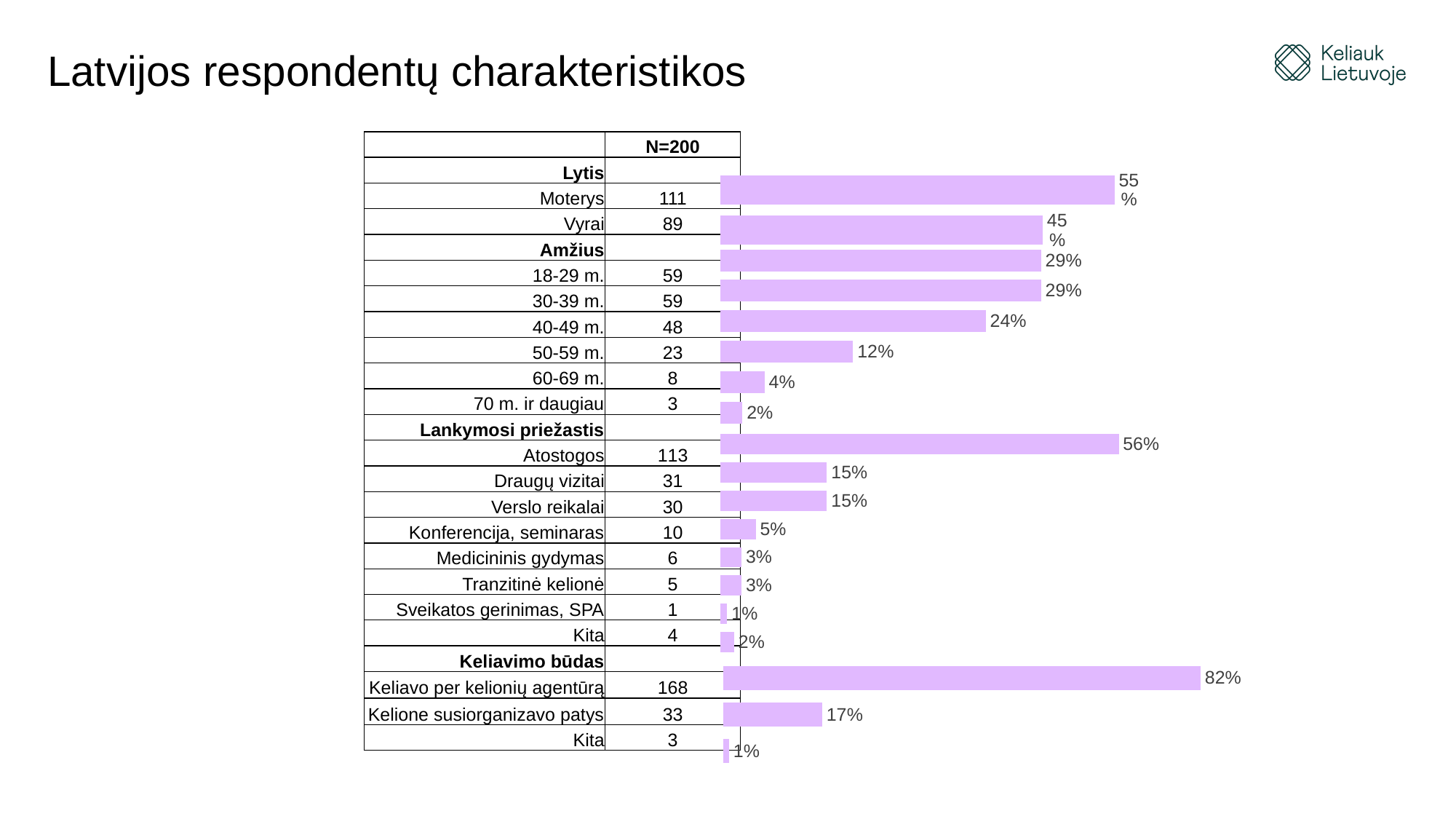
In the Keliavimo būdas section, what percentage is shown for Keliavo per kelionių agentūrą? 82% In the Amžius section, which is larger: the percentage for 50-59 m. or for 60-69 m.? 50-59 m. In the Lankymosi priežastis section, which reason has the highest percentage? Atostogos In the Lankymosi priežastis section, what is the difference in percentage points between Atostogos and Draugų vizitai? 41 What type of chart is used to display the percentages on the slide? Bar chart In the Lankymosi priežastis section, what percentage is shown for Konferencija, seminaras? 5% What percentage is shown for Moterys in the Lytis section? 55% In the Keliavimo būdas section, what is the difference in percentage points between Keliavo per kelionių agentūrą and Kelione susiorganizavo patys? 65 What percentage is shown for Vyrai in the Lytis section? 45% How many age groups are shown in the Amžius section? 6 In the Amžius section, what percentage is shown for 40-49 m.? 24% In the Amžius section, which age group has the lowest percentage? 70 m. ir daugiau